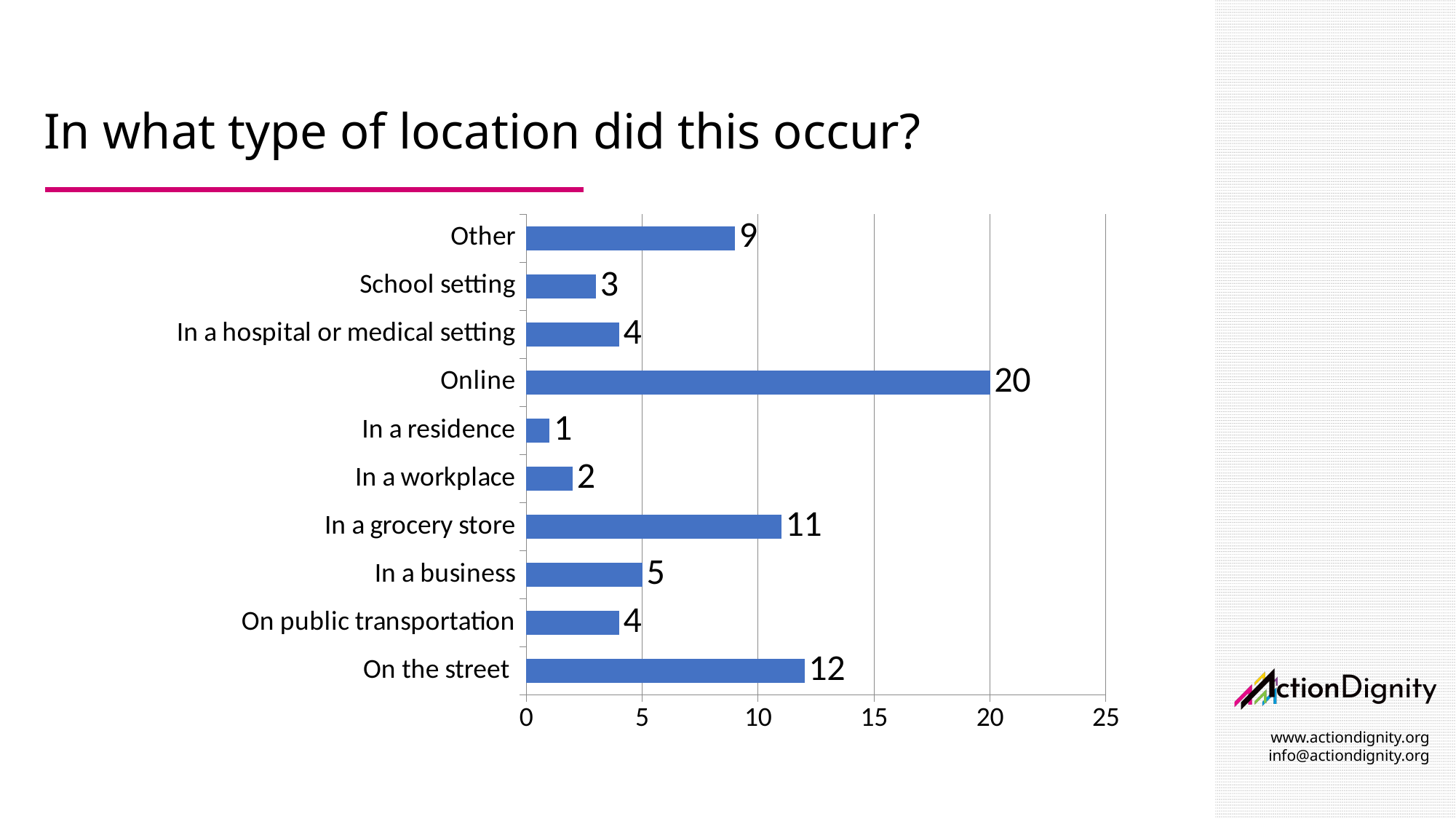
Which is larger, the value for In a business or the value for In a workplace? In a business What is the title of the slide? In what type of location did this occur? What is the value for School setting? 3 What is the value for On the street? 12 What is the difference between the values for Online and On the street? 8 What is the value for In a grocery store? 11 What is the value for Online? 20 Is the value for Other greater or less than 10? less Which location has the lowest value? In a residence Which location has the highest value? Online How many location categories are shown in the chart? 10 What kind of chart is shown on the slide? bar chart